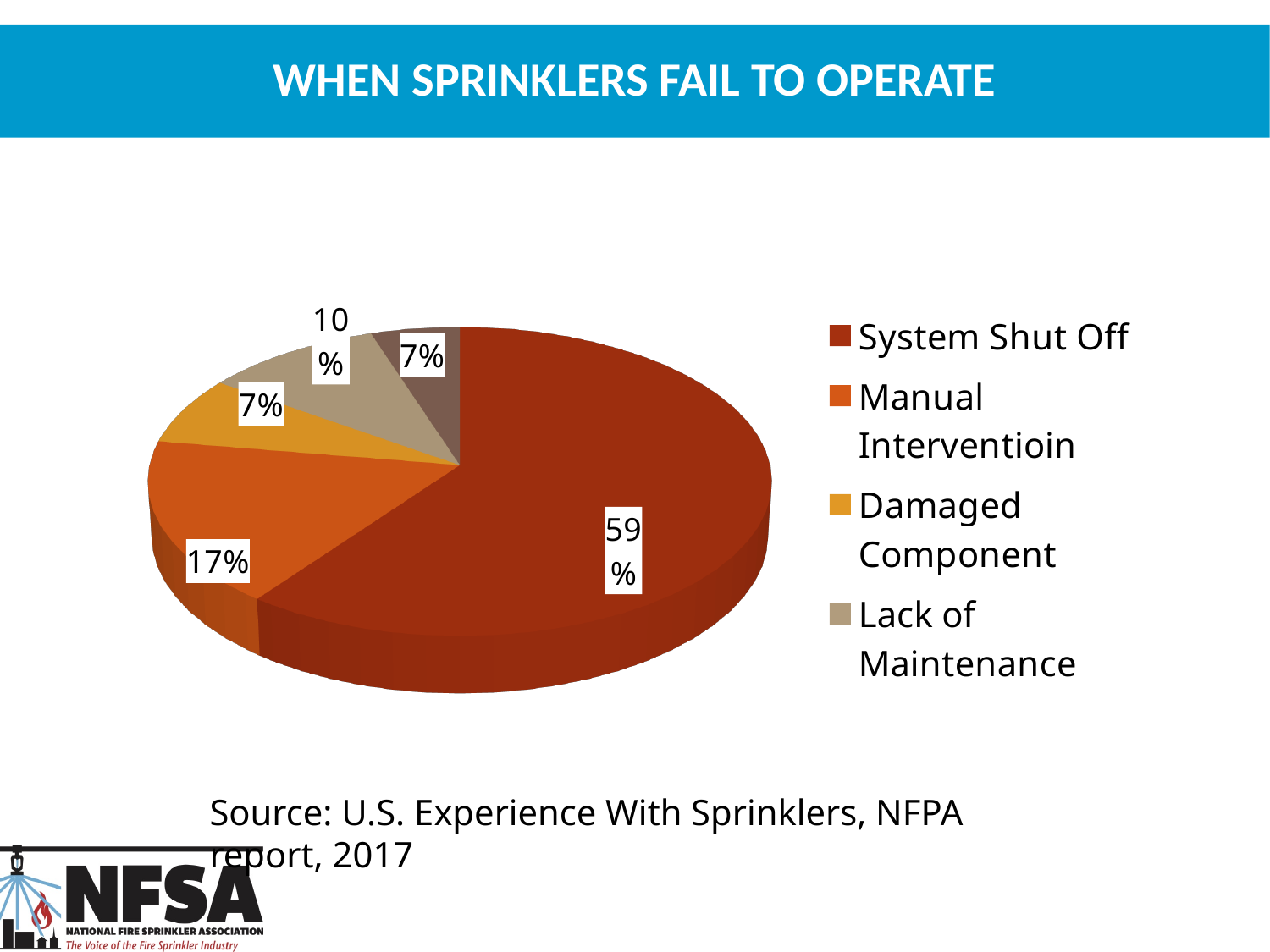
What value is shown for Lack of Maintenance? 10% What value is shown for Manual Interventioin? 17% What value is shown for Damaged Component? 7% What share of the pie does System Shut Off account for? 59% What percentage of the pie is labelled for System Shut Off? 59% What is the title of the slide containing the chart? WHEN SPRINKLERS FAIL TO OPERATE Which is larger, the slice for Lack of Maintenance or the slice for Damaged Component? Lack of Maintenance How many entries does the legend list? 4 Which category has the largest slice of the pie? System Shut Off How many slices with data labels does the pie chart have? 5 What kind of chart is shown on the slide? Pie chart What is the difference in percentage points between System Shut Off and Manual Interventioin? 42